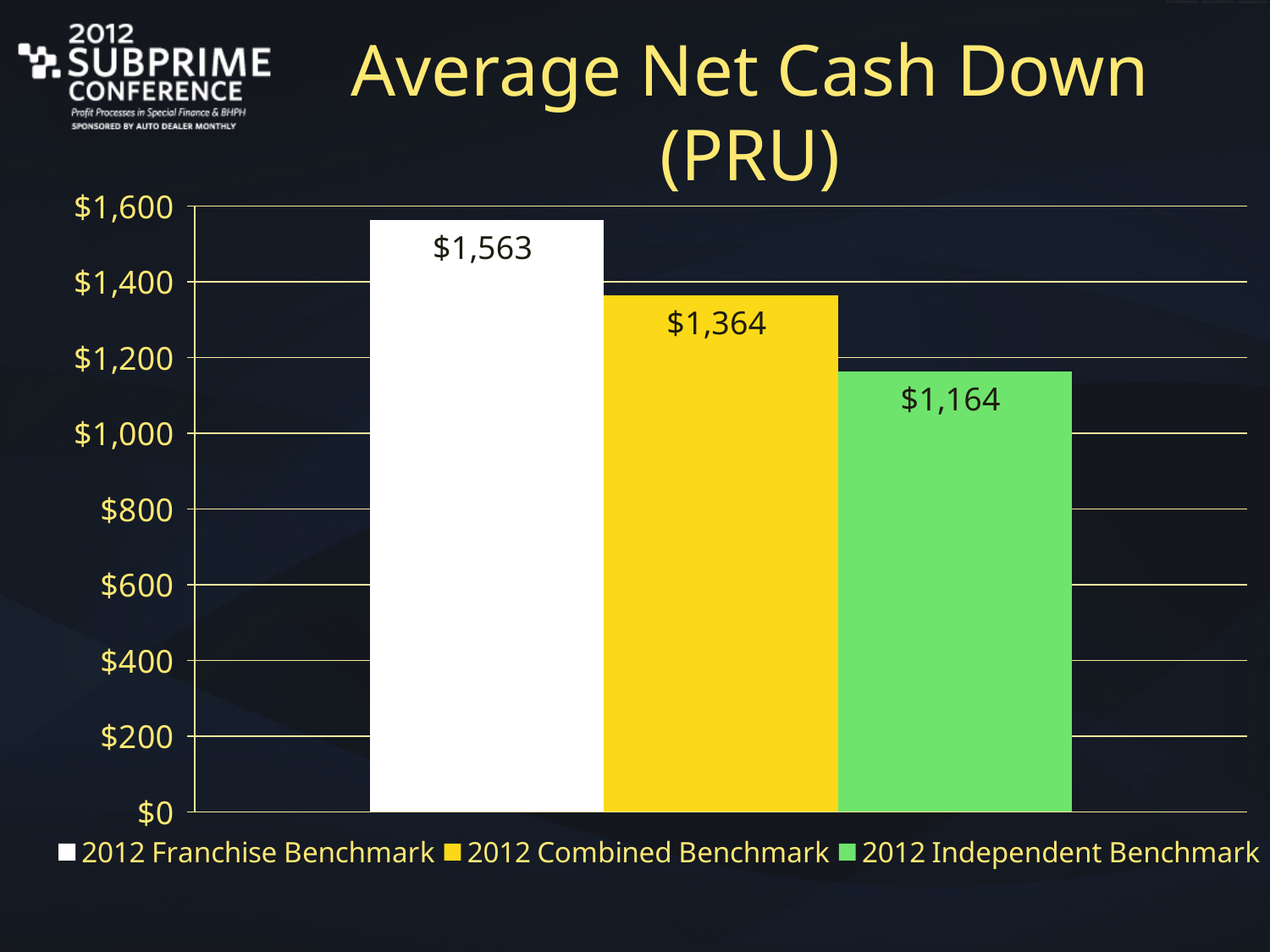
Which series has the lowest average net cash down? 2012 Independent Benchmark How many series does the legend list? 3 Which series has the highest average net cash down? 2012 Franchise Benchmark What is the value for the 2012 Combined Benchmark? $1,364 What is the difference between the 2012 Combined Benchmark and the 2012 Independent Benchmark? $200 What is the value for the 2012 Franchise Benchmark? $1,563 What is the title of the chart? Average Net Cash Down (PRU) Which is larger, the 2012 Franchise Benchmark or the 2012 Combined Benchmark? 2012 Franchise Benchmark What is the difference between the 2012 Franchise Benchmark and the 2012 Independent Benchmark? $399 What kind of chart is shown on the slide? bar chart What is the value for the 2012 Independent Benchmark? $1,164 Is the value for the 2012 Combined Benchmark greater or less than $1,400? less